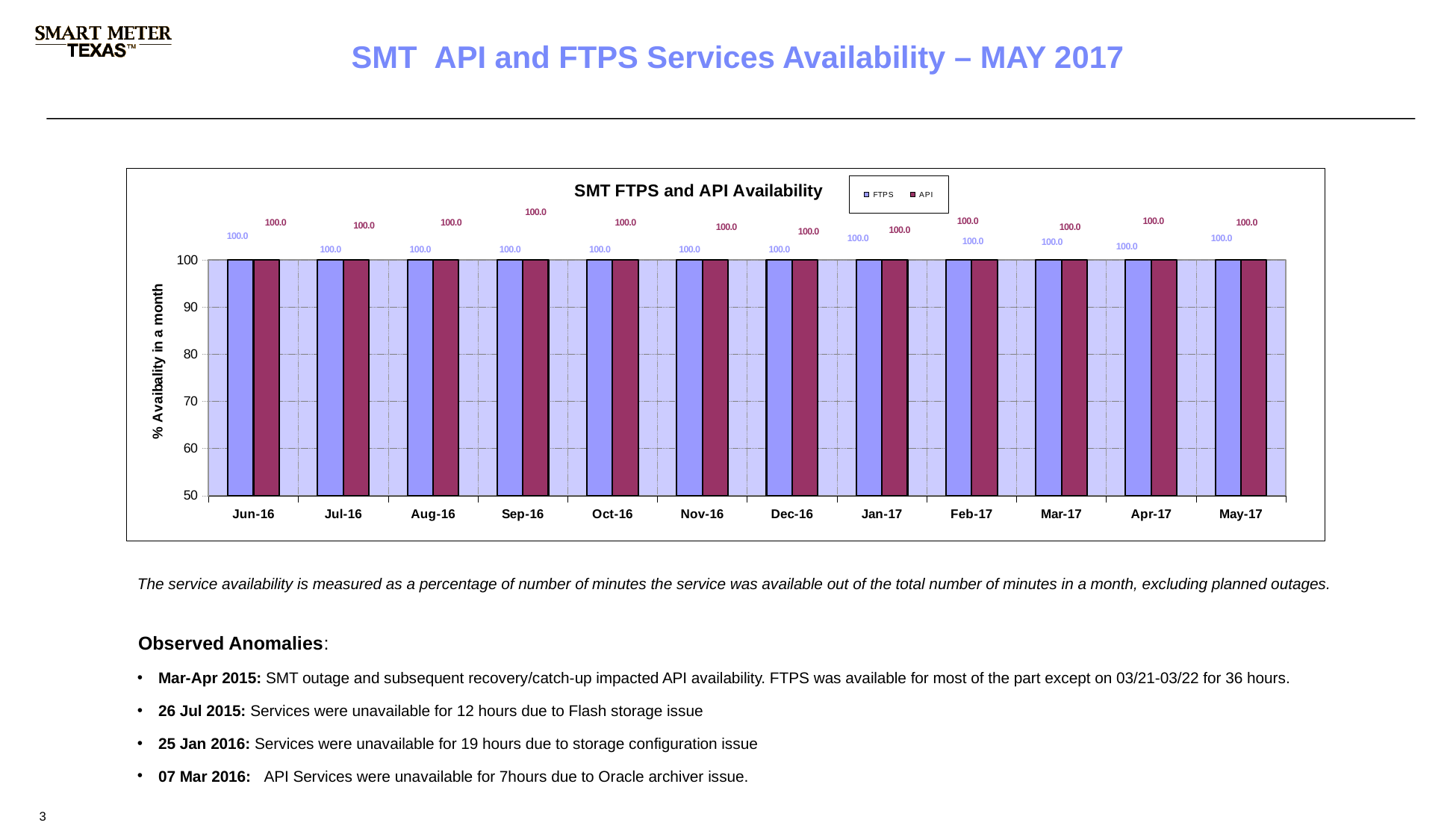
What is the API availability value for May-17? 100.0 Is the FTPS availability value for Mar-17 greater or less than 90? greater What is the FTPS availability value for Jun-16? 100.0 What is the label of the y axis of the chart? % Avaibality in a month What kind of chart is shown on the slide? bar chart How many months are shown on the x axis of the chart? 12 What is the FTPS availability value for Dec-16? 100.0 What is the difference between the FTPS and API availability values for Jan-17? 0.0 Do the FTPS availability values rise, fall, or stay flat from Jun-16 to May-17? stay flat What is the API availability value for Sep-16? 100.0 How many series does the chart legend list? 2 What is the title of the chart? SMT FTPS and API Availability